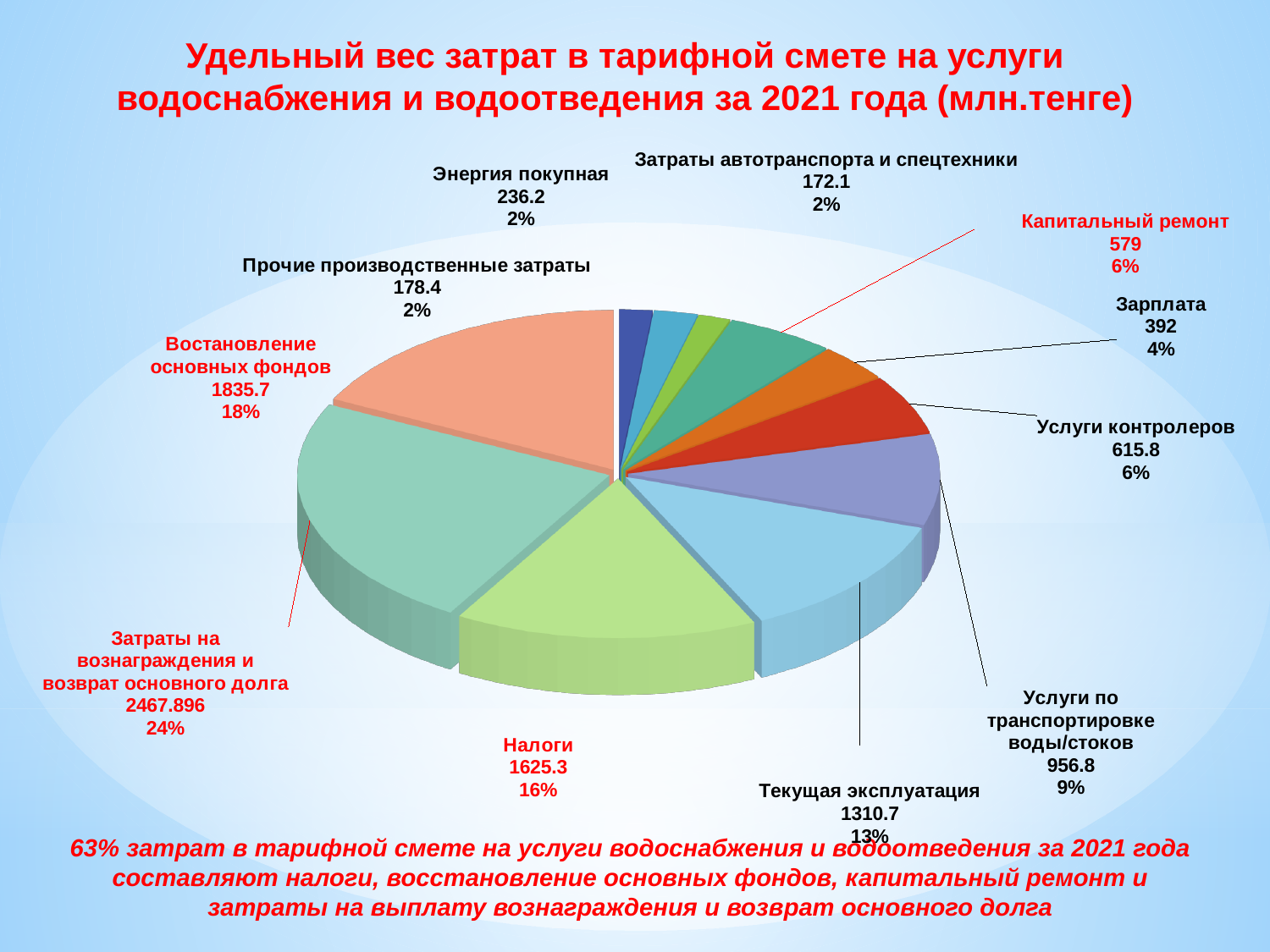
How many categories are shown in the pie chart? 11 What share of the pie does Налоги represent? 16% What value is shown for Текущая эксплуатация? 1310.7 What is the difference between the values for Востановление основных фондов and Налоги? 210.4 Which category has the largest value in the pie chart? Затраты на вознаграждения и возврат основного долга What share of the pie does Затраты на вознаграждения и возврат основного долга represent? 24% Which category has the smallest value in the pie chart? Затраты автотранспорта и спецтехники What kind of chart is shown on the slide? Pie chart Which is larger, the value for Услуги контролеров or the value for Зарплата? Услуги контролеров What value is shown for Налоги? 1625.3 What is the difference between the values for Текущая эксплуатация and Услуги по транспортировке воды/стоков? 353.9 What value is shown for Капитальный ремонт? 579